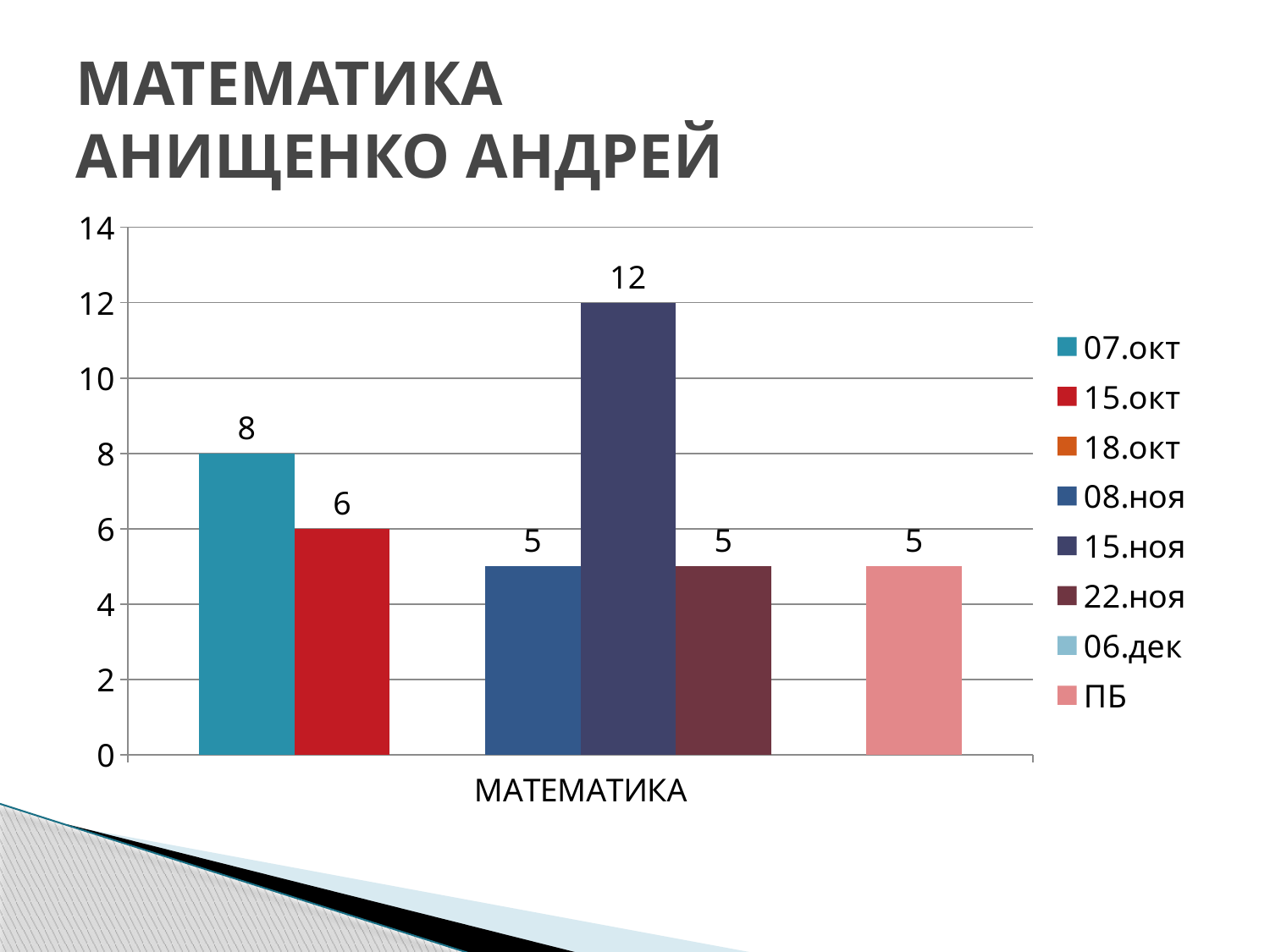
What is the value for 15.ноя? 12 What kind of chart is shown on the slide? bar chart What is the difference between the values for 07.окт and 15.окт? 2 Which series has the highest value? 15.ноя Is the value for 15.ноя greater or less than 10? greater What is the value for 15.окт? 6 How many series does the legend list? 8 What is the difference between the values for 15.ноя and 07.окт? 4 Which is larger, the value for 15.окт or the value for 08.ноя? 15.окт What is the value for ПБ? 5 What is the value for 07.окт in the МАТЕМАТИКА chart? 8 What is the category label on the x axis? МАТЕМАТИКА